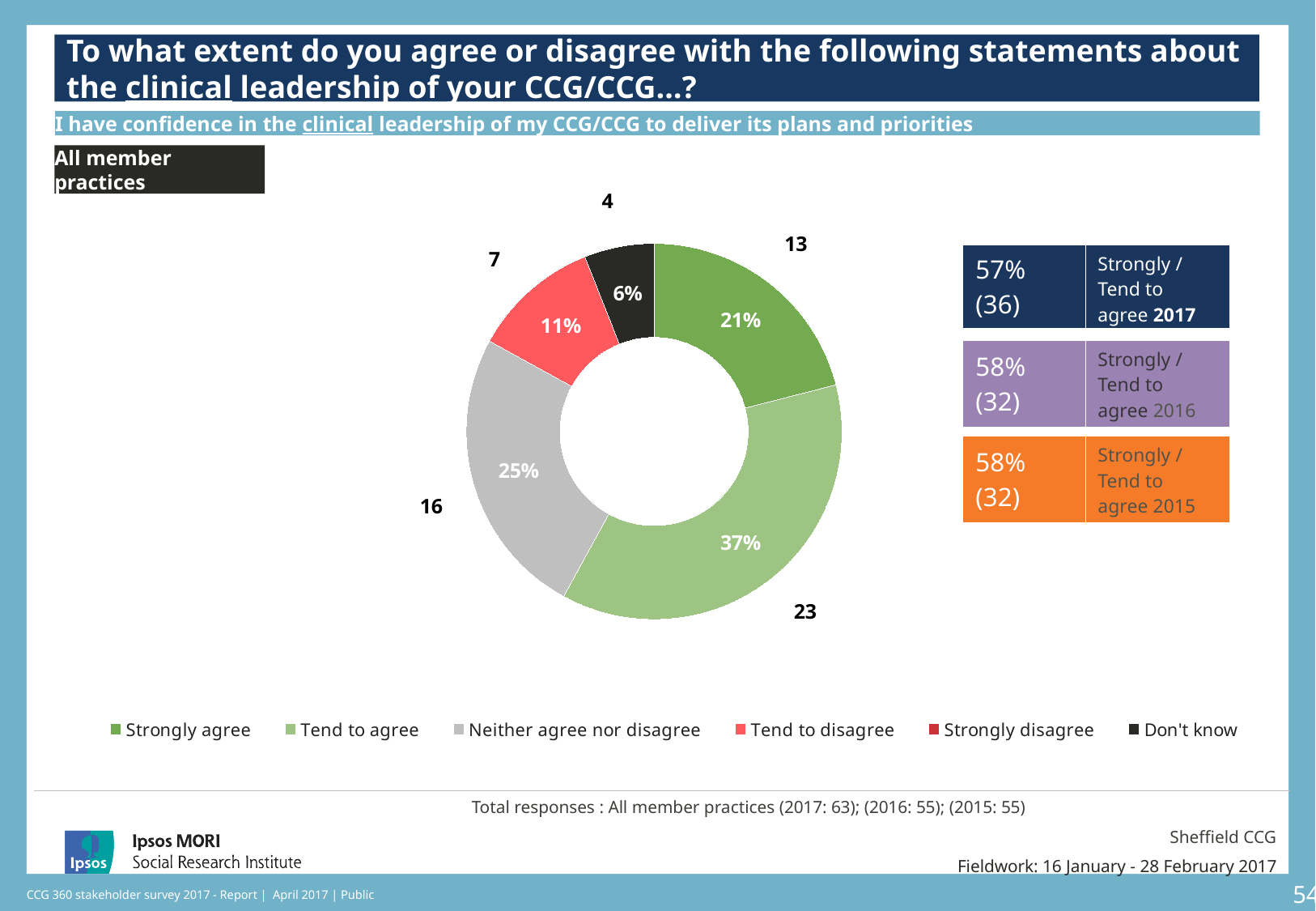
What is the difference in percentage points between 'Tend to agree' and 'Strongly agree'? 16 What was the combined 'Strongly / Tend to agree' percentage in 2017? 57% Which response category has the largest share of the donut chart? Tend to agree What percentage of respondents answered 'Neither agree nor disagree'? 25% How many entries does the legend list? 6 What percentage of respondents said they 'Tend to agree'? 37% How many respondents said they 'Tend to disagree'? 7 Which labelled segment of the donut chart has the smallest share? Don't know Which is larger: the share for 'Neither agree nor disagree' or the share for 'Tend to disagree'? Neither agree nor disagree What percentage of respondents answered 'Don't know'? 6% What percentage of respondents said they 'Strongly agree'? 21% What type of chart is shown on the slide? Donut (pie) chart